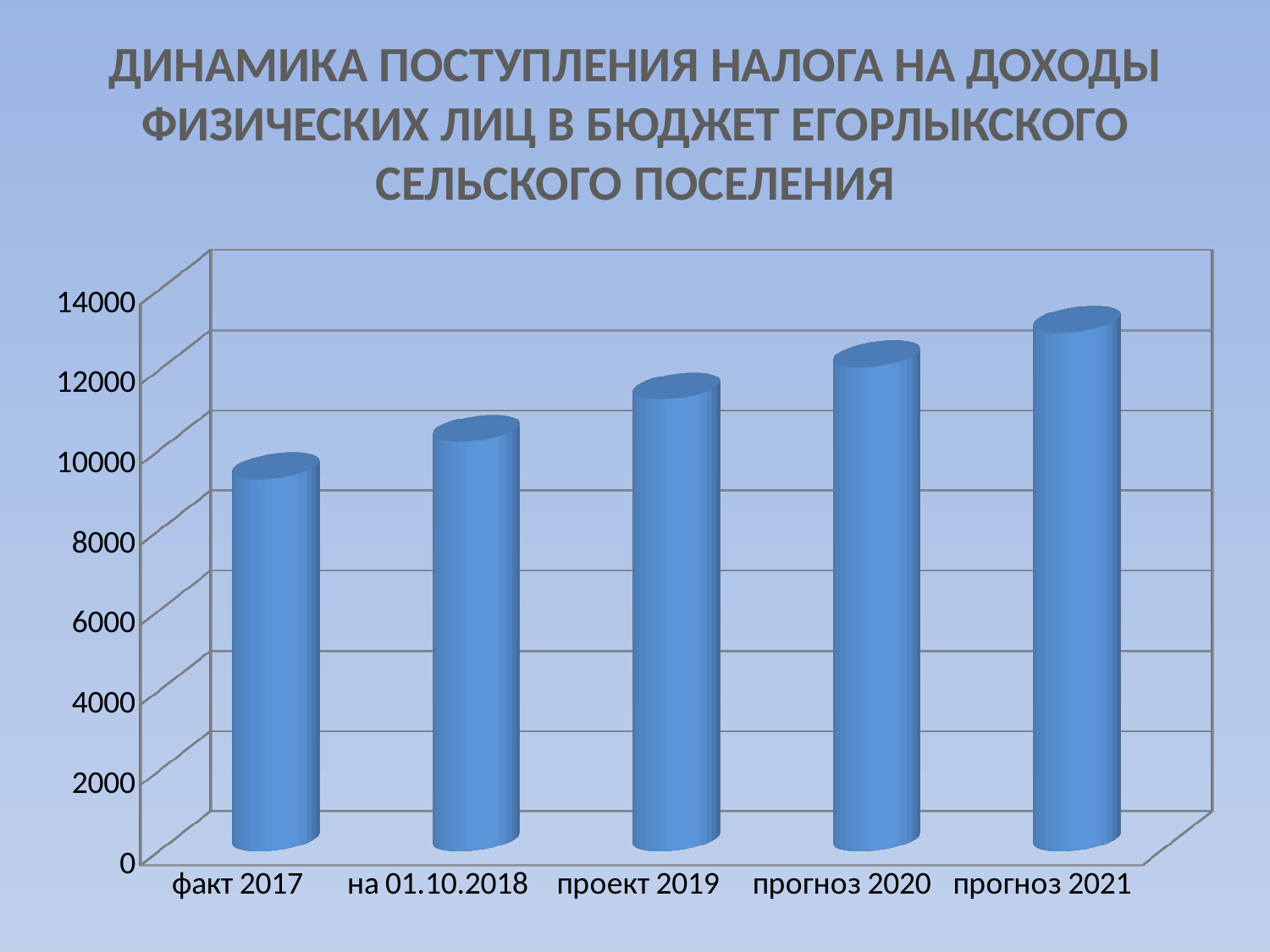
How many categories are plotted along the x axis? 5 Which category has the lowest value? факт 2017 Is the value for факт 2017 greater or less than 12000? less Which category has the highest value? прогноз 2021 Is the value for факт 2017 greater or less than 8000? greater Is the value for прогноз 2021 greater or less than 12000? greater Which is larger, the value for прогноз 2021 or the value for факт 2017? прогноз 2021 Which is larger, the value for прогноз 2020 or the value for на 01.10.2018? прогноз 2020 What is the title of the chart on the slide? ДИНАМИКА ПОСТУПЛЕНИЯ НАЛОГА НА ДОХОДЫ ФИЗИЧЕСКИХ ЛИЦ В БЮДЖЕТ ЕГОРЛЫКСКОГО СЕЛЬСКОГО ПОСЕЛЕНИЯ What kind of chart is shown on the slide? bar chart Do the values rise or fall from факт 2017 to прогноз 2021? rise